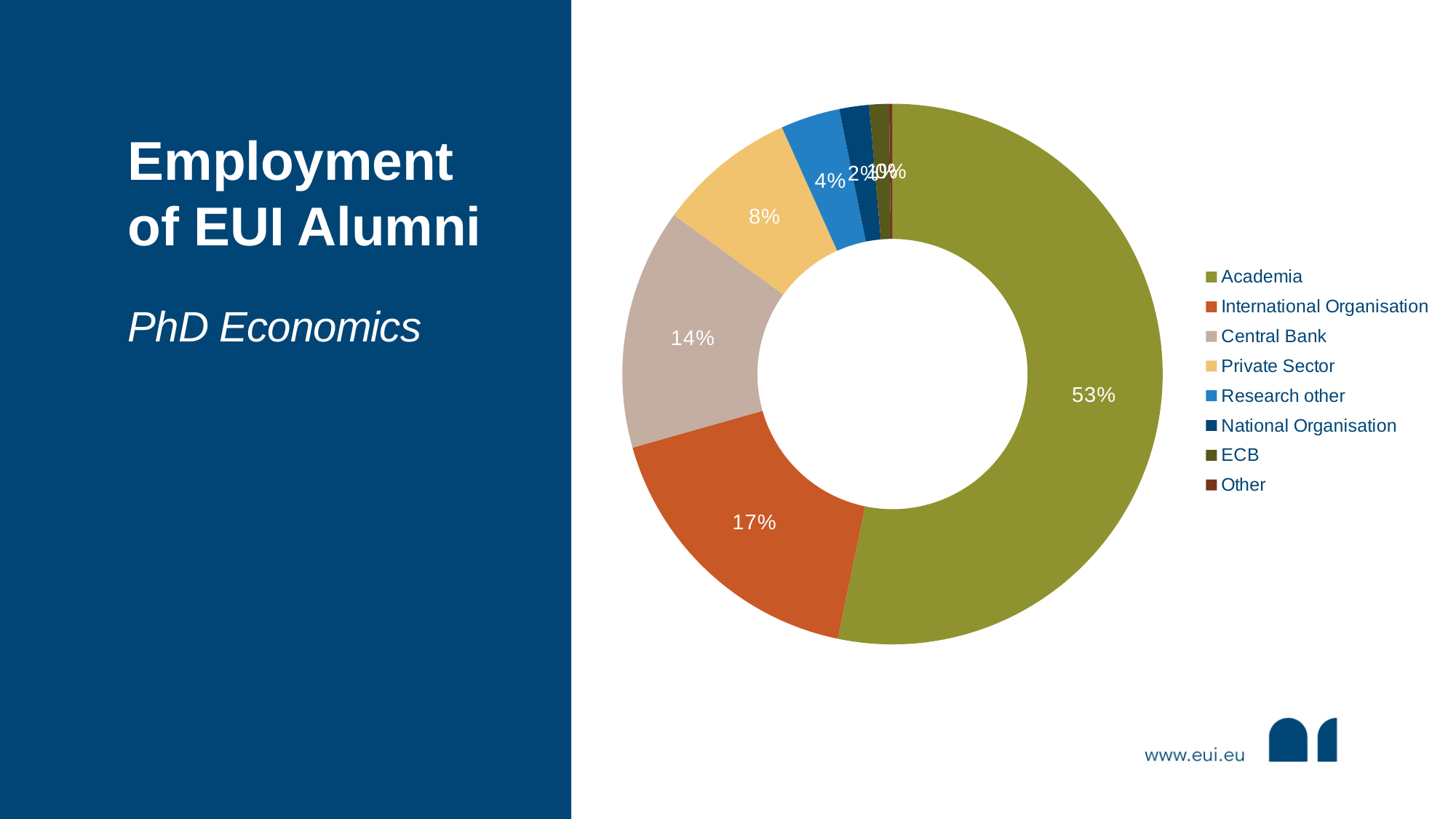
How many categories does the legend list? 8 Which is larger, the share for Central Bank or the share for Private Sector? Central Bank What is the share for Central Bank? 14% What percentage of alumni work in an International Organisation? 17% What is the combined share of Academia and Central Bank? 67% Which colour represents Academia in the chart? Olive green What is the value shown for Research other? 4% What percentage of alumni are in the Private Sector? 8% What is the difference in percentage points between Academia and International Organisation? 36 What share of PhD Economics alumni are employed in Academia? 53% What kind of chart is shown on the slide? Doughnut (pie) chart Which employment category has the largest share? Academia